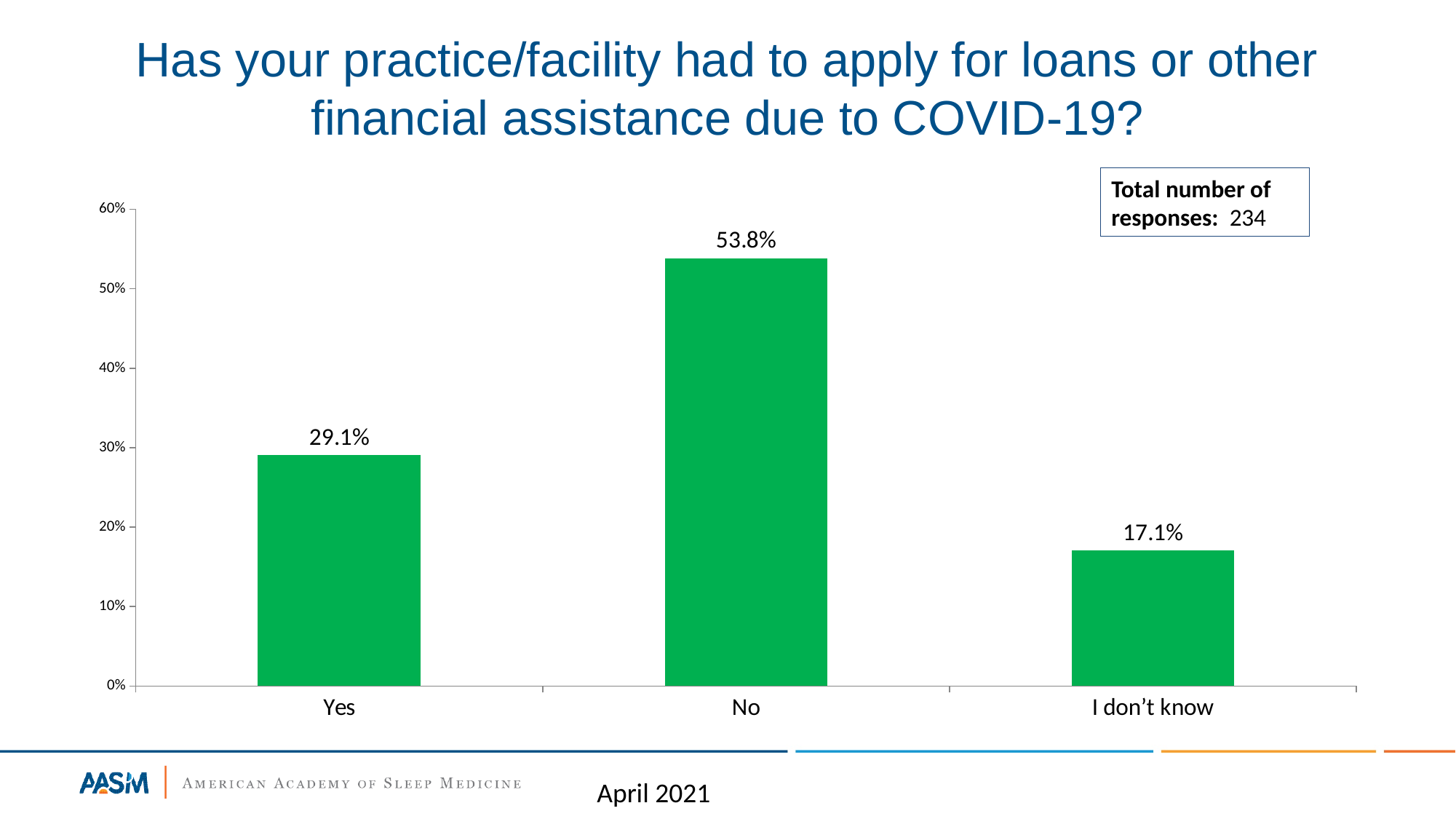
What is the difference in percentage points between the "No" and "Yes" responses? 24.7 Which is larger, the percentage for "Yes" or for "I don't know"? Yes Which response category has the highest percentage? No What is the total number of responses stated on the slide? 234 What percentage of respondents answered "No"? 53.8% What percentage of respondents answered "I don't know"? 17.1% What is the difference in percentage points between the "Yes" and "I don't know" responses? 12.0 How many response categories are shown on the x axis? 3 Is the value for "No" greater or less than 50%? greater Which response category has the lowest percentage? I don't know What kind of chart is shown on the slide? Bar chart What percentage of respondents answered "Yes"? 29.1%